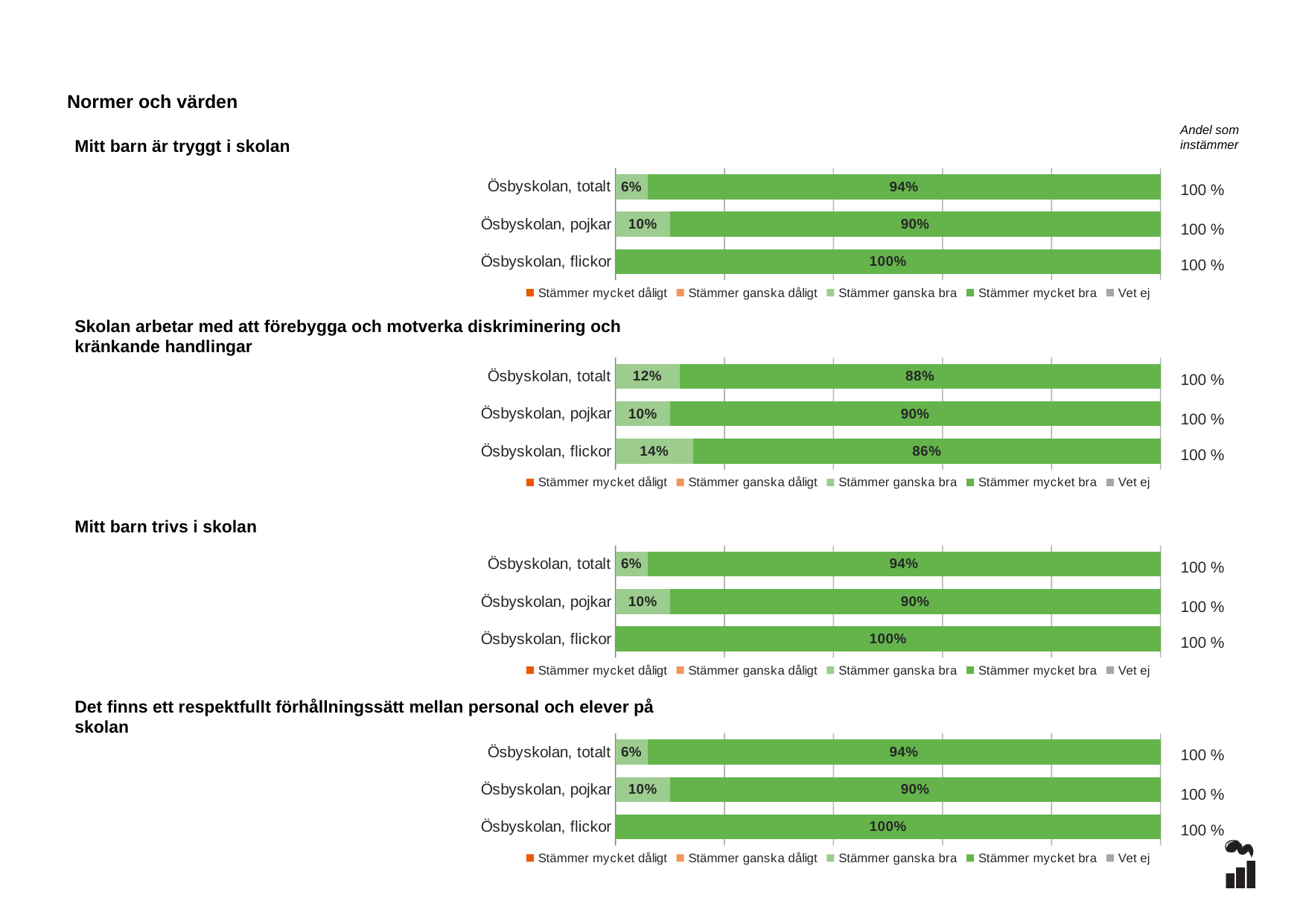
How many series does the legend of the chart 'Mitt barn är tryggt i skolan' list? 5 How many categories are shown in the chart 'Det finns ett respektfullt förhållningssätt mellan personal och elever på skolan'? 3 In the chart 'Skolan arbetar med att förebygga och motverka diskriminering och kränkande handlingar', what is the difference between the 'Stämmer mycket bra' values for Ösbyskolan, pojkar and Ösbyskolan, flickor? 4% What kind of chart is 'Mitt barn trivs i skolan'? Stacked bar chart In the chart 'Skolan arbetar med att förebygga och motverka diskriminering och kränkande handlingar', what is the value of 'Stämmer ganska bra' for Ösbyskolan, flickor? 14% In the chart 'Mitt barn trivs i skolan', which is larger: the 'Stämmer mycket bra' value for Ösbyskolan, totalt or for Ösbyskolan, pojkar? Ösbyskolan, totalt In the chart 'Mitt barn är tryggt i skolan', what is the value of 'Stämmer mycket bra' for Ösbyskolan, totalt? 94% In the chart 'Skolan arbetar med att förebygga och motverka diskriminering och kränkande handlingar', which category has the highest value for 'Stämmer mycket bra'? Ösbyskolan, pojkar In the chart 'Mitt barn är tryggt i skolan', what is the value of 'Stämmer ganska bra' for Ösbyskolan, pojkar? 10% In the chart 'Skolan arbetar med att förebygga och motverka diskriminering och kränkande handlingar', which category has the lowest value for 'Stämmer mycket bra'? Ösbyskolan, flickor In the chart 'Det finns ett respektfullt förhållningssätt mellan personal och elever på skolan', what is the value of 'Stämmer ganska bra' for Ösbyskolan, totalt? 6% In the chart 'Mitt barn trivs i skolan', what is the value of 'Stämmer mycket bra' for Ösbyskolan, flickor? 100%